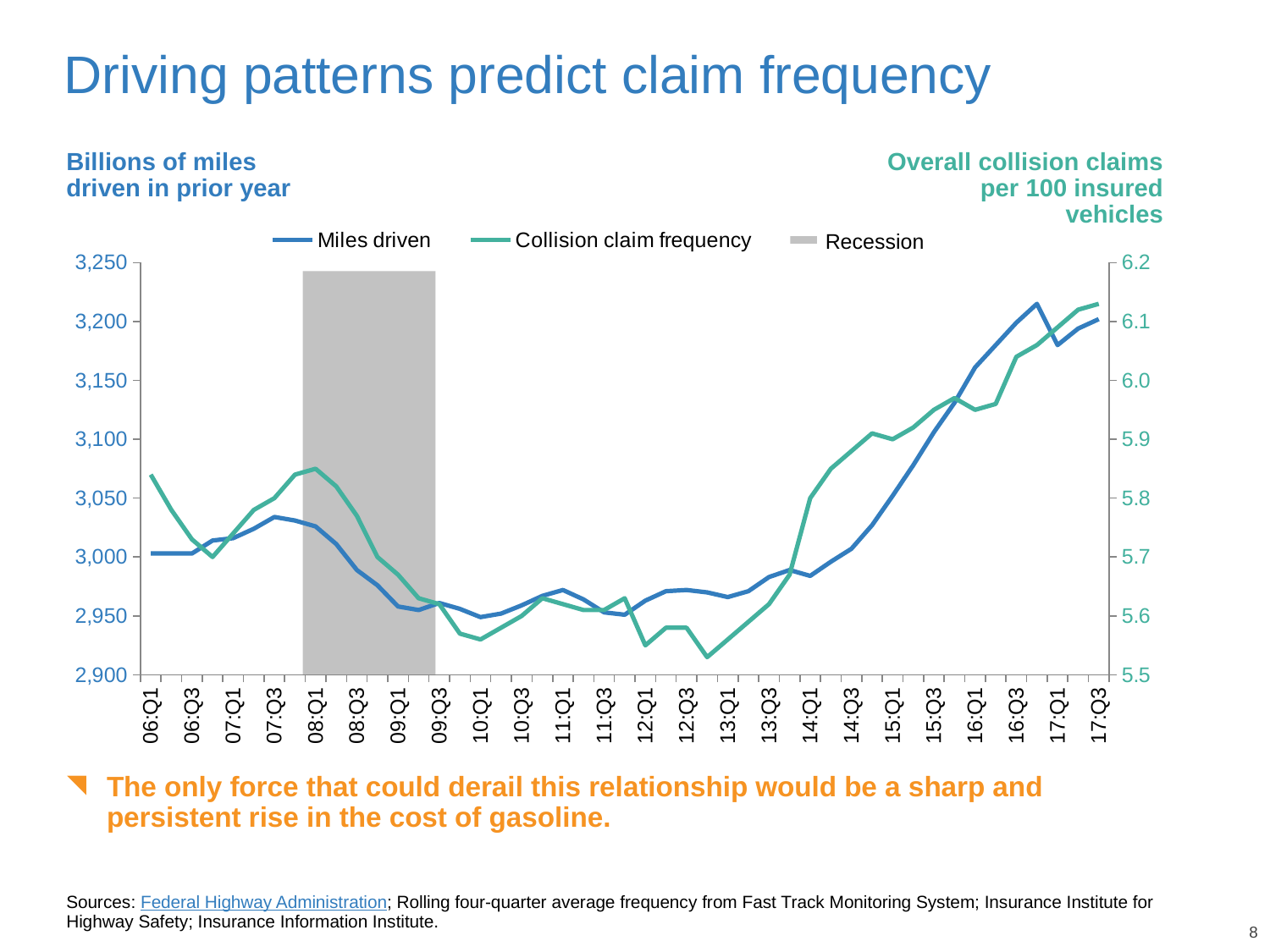
Is the value for Miles driven at 14:Q1 greater or less than 3,000? less What does the right-hand axis of the chart measure? Overall collision claims per 100 insured vehicles Is the value for Collision claim frequency at 13:Q1 greater or less than 5.6? less What is the title of the slide's chart? Driving patterns predict claim frequency Does the Collision claim frequency line rise or fall between 08:Q1 and 10:Q1? Fall Does the Miles driven line rise or fall between 14:Q1 and 16:Q3? Rise Is the value for Collision claim frequency at 17:Q3 greater or less than 6.0? greater How many entries does the legend list? 3 How many quarter labels are shown along the x axis? 24 What kind of chart is shown on the slide? Line chart